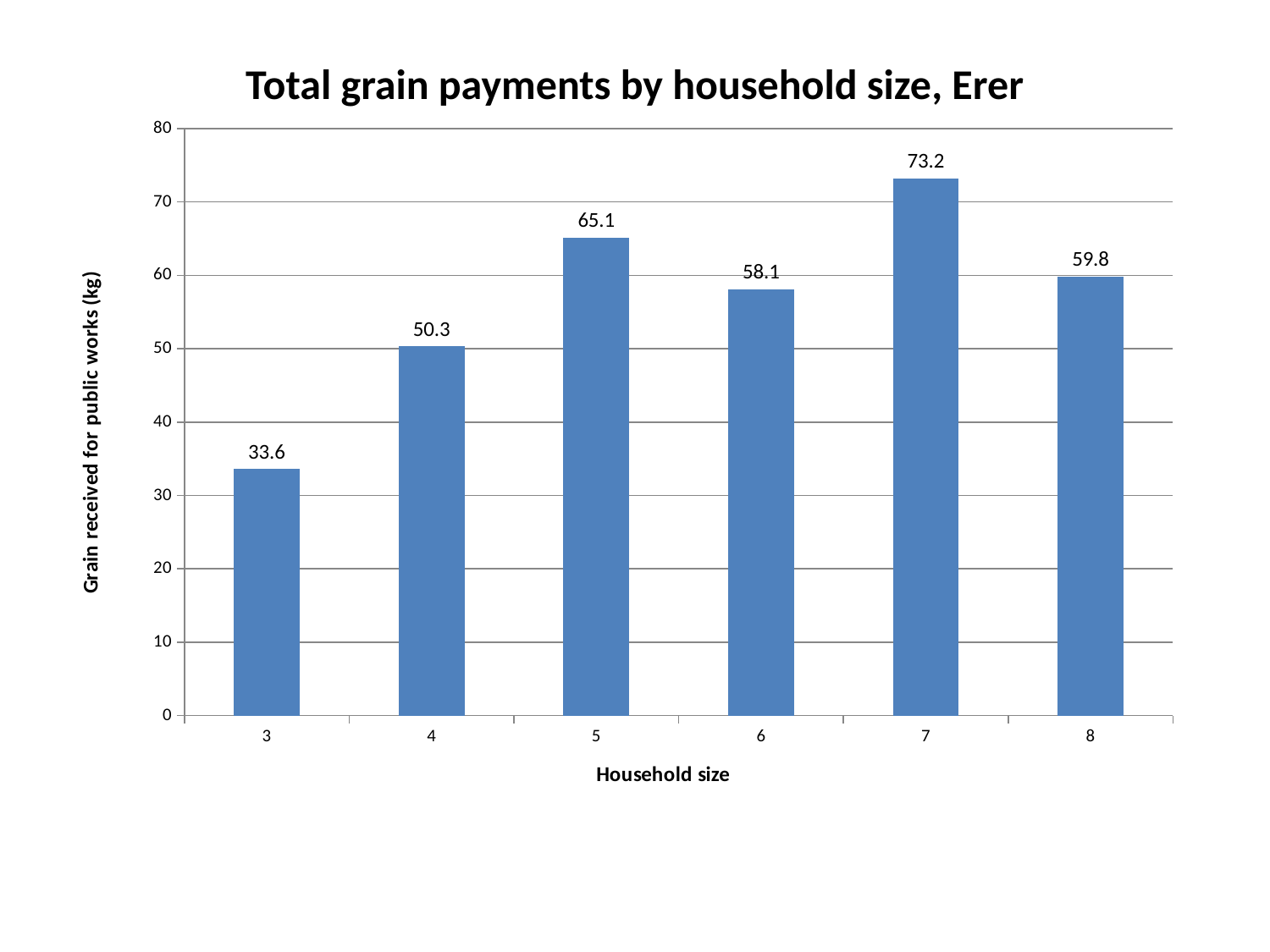
Which household size received the least grain? 3 Is the value for household size 4 greater or less than 60? less What is the label of the vertical axis? Grain received for public works (kg) What is the grain received for a household size of 3? 33.6 What is the grain received for a household size of 5? 65.1 What is the grain received for a household size of 7? 73.2 Which household size received the most grain? 7 What is the difference in grain received between household size 7 and household size 3? 39.6 Which received more grain, household size 6 or household size 8? Household size 8 How many household size categories are shown on the chart? 6 What kind of chart is shown on the slide? Bar chart What is the difference in grain received between household size 5 and household size 4? 14.8